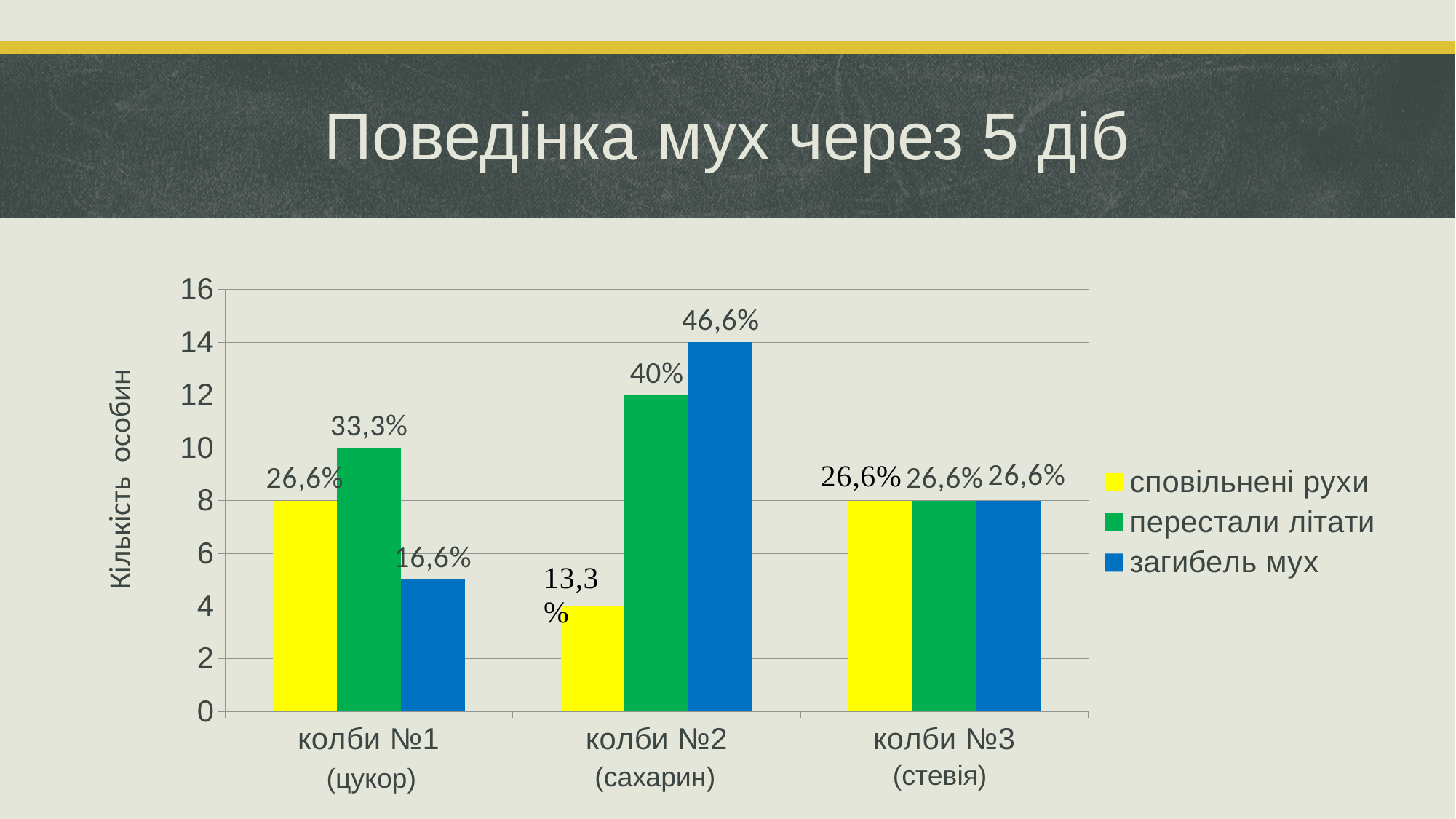
What kind of chart is shown on the slide? bar chart Which is larger: the 'перестали літати' bar for 'колби №1 (цукор)' or for 'колби №2 (сахарин)'? колби №2 (сахарин) How many categories (колби) are shown on the x axis? 3 What is the data label on the 'сповільнені рухи' bar for 'колби №2 (сахарин)'? 13,3% How many individuals (Кількість особин) does the 'перестали літати' bar for 'колби №2 (сахарин)' reach on the axis? 12 What is the data label on the 'загибель мух' bar for 'колби №2 (сахарин)'? 46,6% Which series has the lowest bar in the 'колби №2 (сахарин)' group? сповільнені рухи What is the difference between the 'загибель мух' and 'перестали літати' data labels for 'колби №2 (сахарин)'? 6,6% What is the data label on the 'перестали літати' bar for 'колби №1 (цукор)'? 33,3% Is the value for 'загибель мух' in 'колби №1 (цукор)' greater or less than 6? less How many series does the legend list? 3 Which category has the highest bar overall in the chart? колби №2 (сахарин)